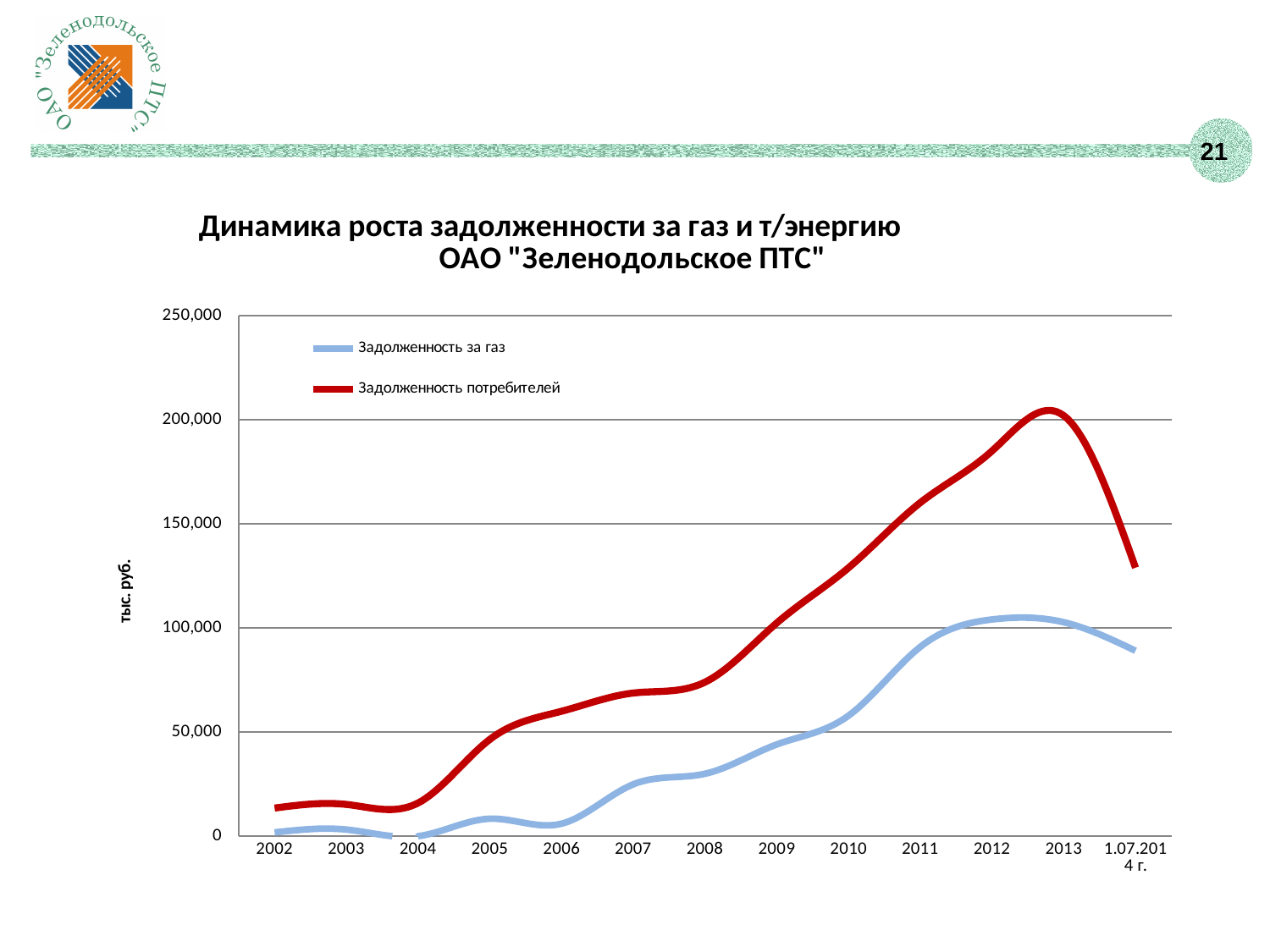
Is the value of "Задолженность за газ" in 2009 greater or less than 50,000? less Does the series "Задолженность потребителей" rise or fall between 2013 and 1.07.2014 г.? fall How many points are marked along the x axis? 13 Is the value of "Задолженность потребителей" in 2011 greater or less than 150,000? greater In 2010, which series has the larger value: "Задолженность за газ" or "Задолженность потребителей"? Задолженность потребителей How many series does the legend list? 2 In which year does the series "Задолженность потребителей" reach its highest value? 2013 Is the value of "Задолженность за газ" in 2012 greater or less than 100,000? greater What kind of chart is shown on the slide? line chart In which year is the series "Задолженность за газ" at its lowest value? 2004 What unit is shown on the y axis label? тыс. руб.